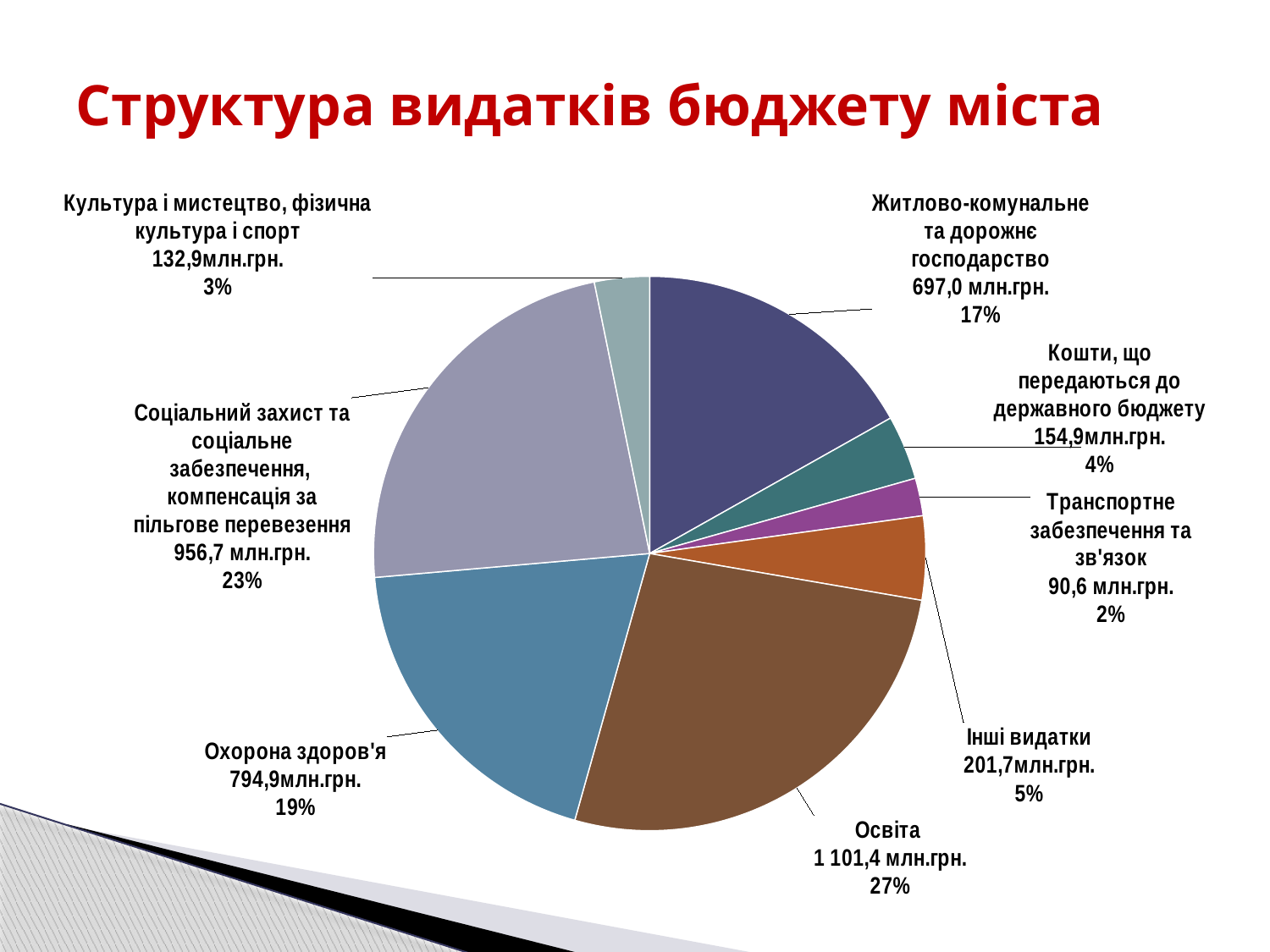
What is the difference in percentage points between Освіта and Охорона здоров'я? 8 Which category has the largest share of the pie? Освіта What is the title of the slide? Структура видатків бюджету міста What is the value for Освіта? 1 101,4 млн.грн. Which category has the smallest share of the pie? Транспортне забезпечення та зв'язок What share of the pie does Охорона здоров'я represent? 19% What is the value for Кошти, що передаються до державного бюджету? 154,9 млн.грн. Which is larger: Соціальний захист та соціальне забезпечення, компенсація за пільгове перевезення or Житлово-комунальне та дорожнє господарство? Соціальний захист та соціальне забезпечення, компенсація за пільгове перевезення How many slices does the pie chart have? 8 What is the value for Житлово-комунальне та дорожнє господарство? 697,0 млн.грн. What type of chart is shown on the slide? pie chart What share of the pie does Інші видатки represent? 5%